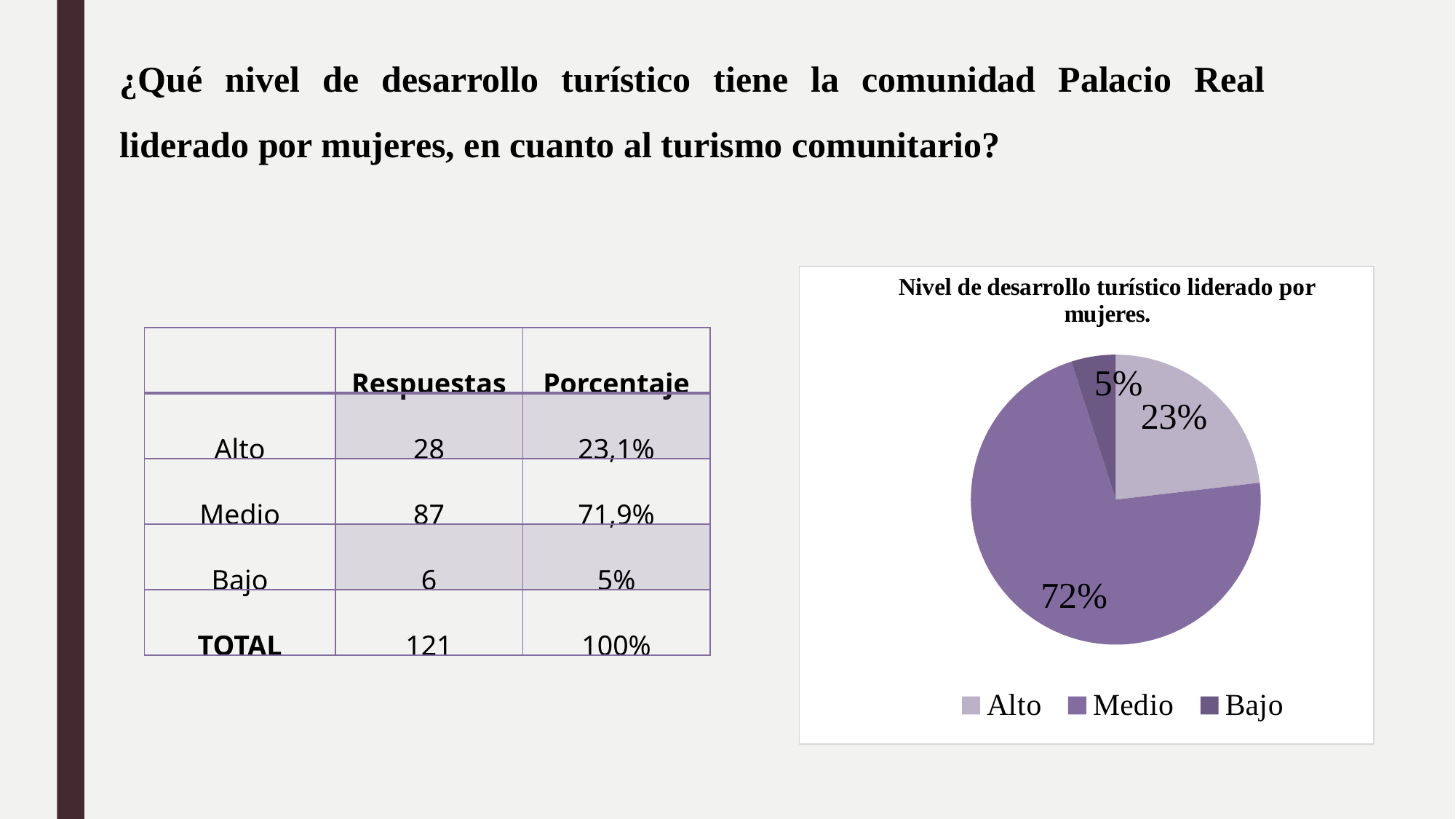
Which legend entry is shown with the lightest shade of purple in the pie chart? Alto What kind of chart is shown on the slide? pie chart How many slices does the pie chart have? 3 What is the difference in percentage points between the Medio and Alto slices in the pie chart? 49 Which category has the largest slice in the pie chart? Medio What is the title of the chart? Nivel de desarrollo turístico liderado por mujeres. How many entries does the legend of the pie chart list? 3 Which slice is larger in the pie chart, Alto or Bajo? Alto Which category has the smallest slice in the pie chart? Bajo What percentage does the Bajo slice show in the pie chart? 5% What percentage does the Alto slice show in the pie chart? 23% What percentage does the Medio slice show in the pie chart? 72%